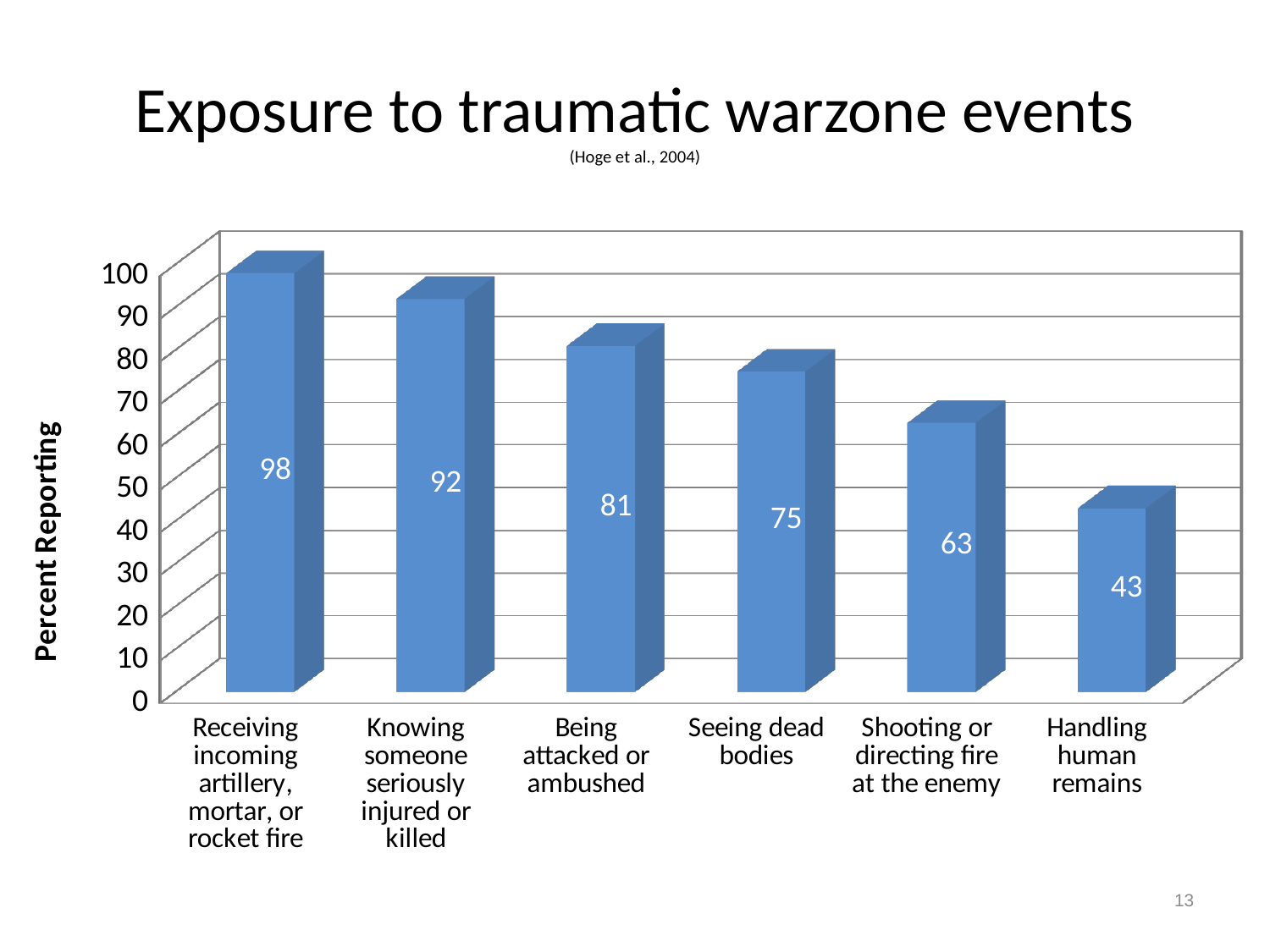
What percent reported receiving incoming artillery, mortar, or rocket fire? 98 What kind of chart is shown on the slide? Bar chart What percent reported handling human remains? 43 Is the value for 'Shooting or directing fire at the enemy' greater or less than 70? less Which event has the lowest percent reporting? Handling human remains Which is larger: the value for 'Shooting or directing fire at the enemy' or the value for 'Seeing dead bodies'? Seeing dead bodies Do the values rise or fall from left to right across the categories? Fall What is the value for 'Seeing dead bodies'? 75 Which event has the highest percent reporting? Receiving incoming artillery, mortar, or rocket fire How many event categories are shown on the chart? 6 What is the label of the vertical axis? Percent Reporting What is the difference between the values for 'Knowing someone seriously injured or killed' and 'Being attacked or ambushed'? 11